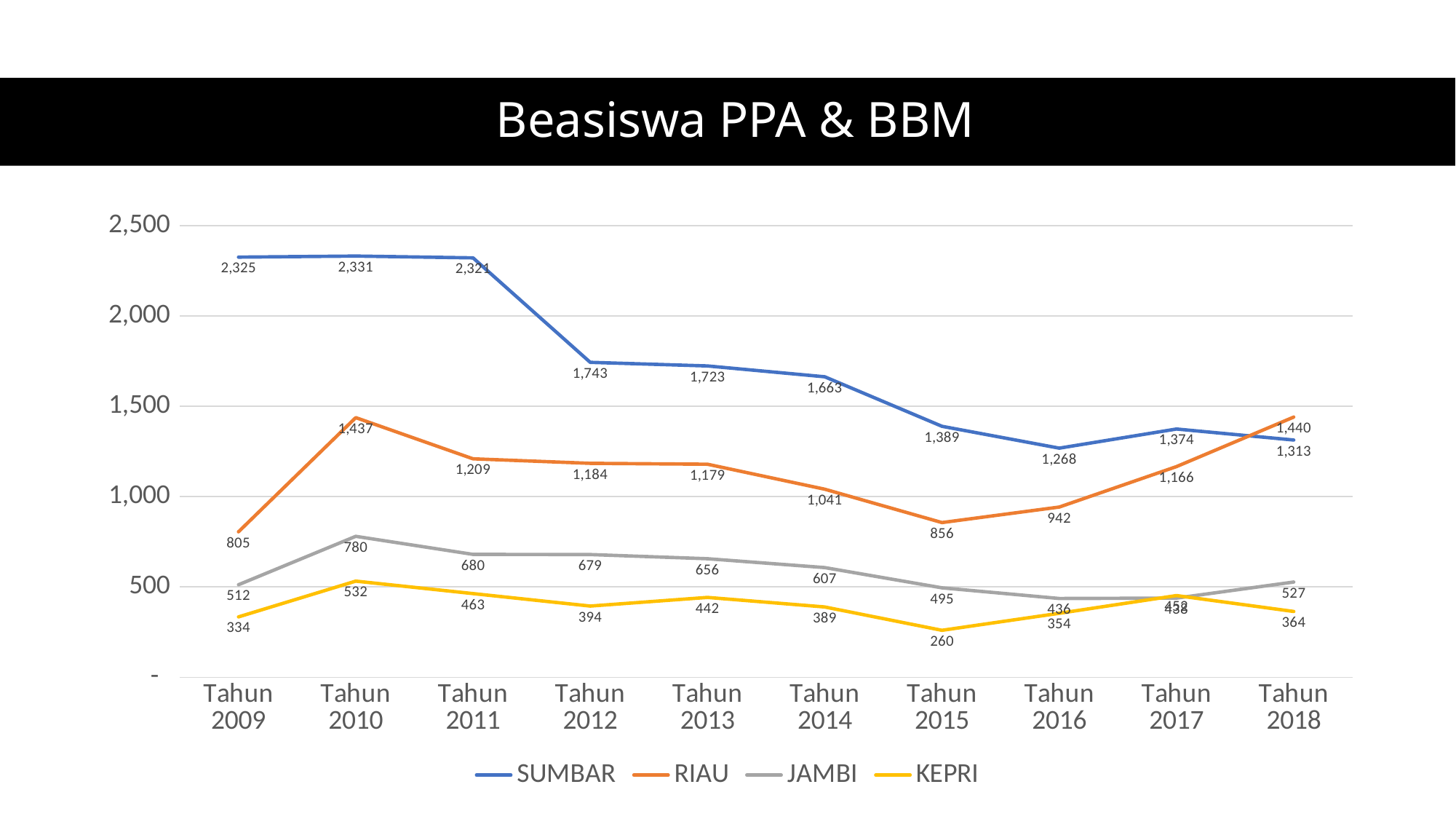
What is the title of the chart? Beasiswa PPA & BBM What is the difference between the SUMBAR values for Tahun 2011 and Tahun 2012? 578 In Tahun 2018, which series has the larger value, RIAU or SUMBAR? RIAU What kind of chart is shown on the slide? line chart What is the value for SUMBAR in Tahun 2012? 1,743 How many years are plotted along the x axis? 10 Does the SUMBAR line rise or fall from Tahun 2011 to Tahun 2016? fall How many series does the legend list? 4 In which year does SUMBAR reach its highest value? Tahun 2010 What is the value for JAMBI in Tahun 2010? 780 What is the value for RIAU in Tahun 2015? 856 In which year does KEPRI have its lowest value? Tahun 2015